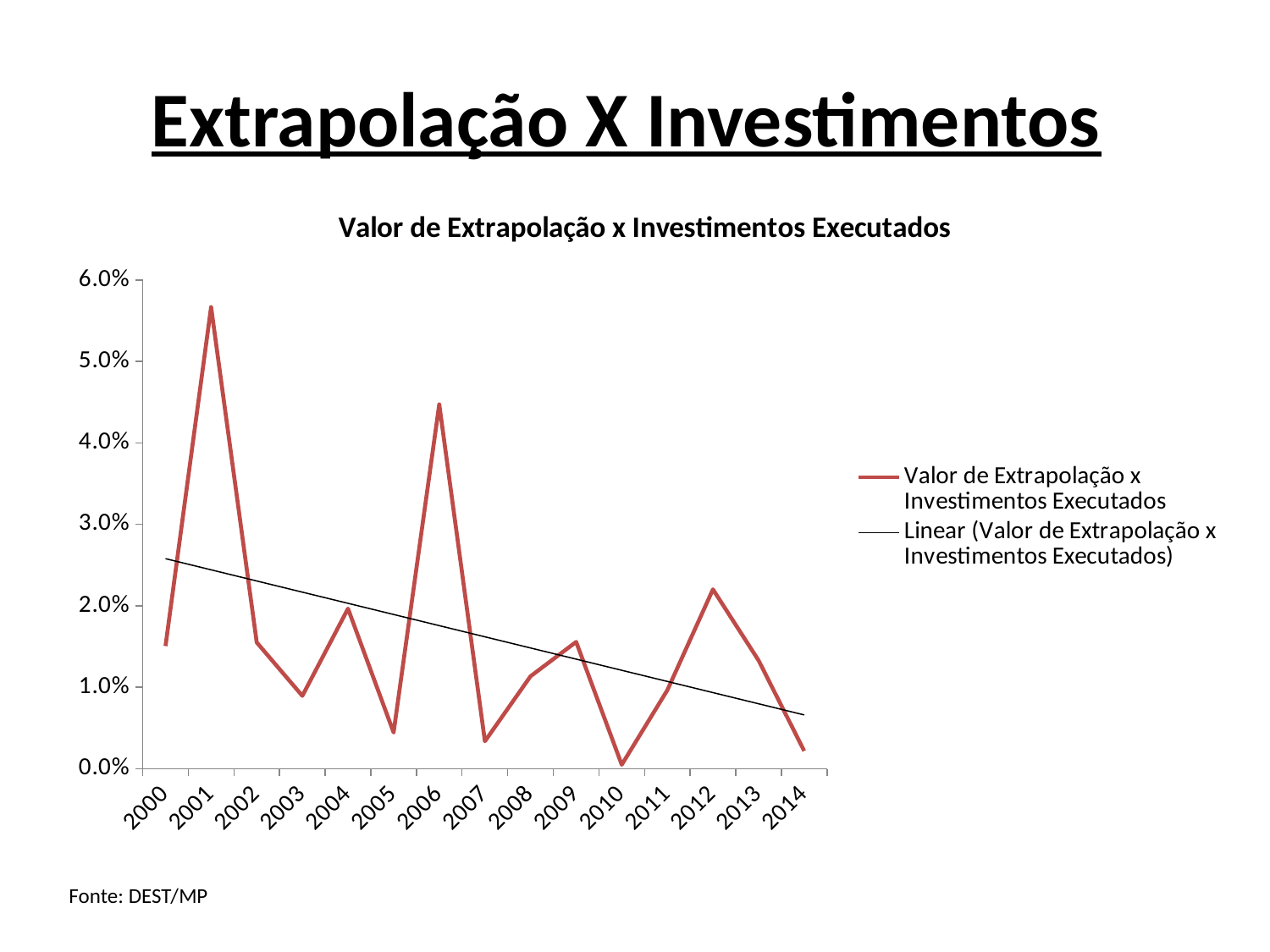
Is the value for 2012 greater or less than 2.0%? greater Is the value for 2010 greater or less than 1.0%? less Which year has the larger value, 2001 or 2006? 2001 Is the value for 2006 greater or less than 4.0%? greater How many entries does the chart legend list? 2 Does the linear trend line rise or fall from 2000 to 2014? fall What is the title of the chart? Valor de Extrapolação x Investimentos Executados What kind of chart is shown on the slide? line chart How many years are shown on the x axis of the chart? 15 In which year is the value of Valor de Extrapolação x Investimentos Executados highest? 2001 In which year is the value of Valor de Extrapolação x Investimentos Executados lowest? 2010